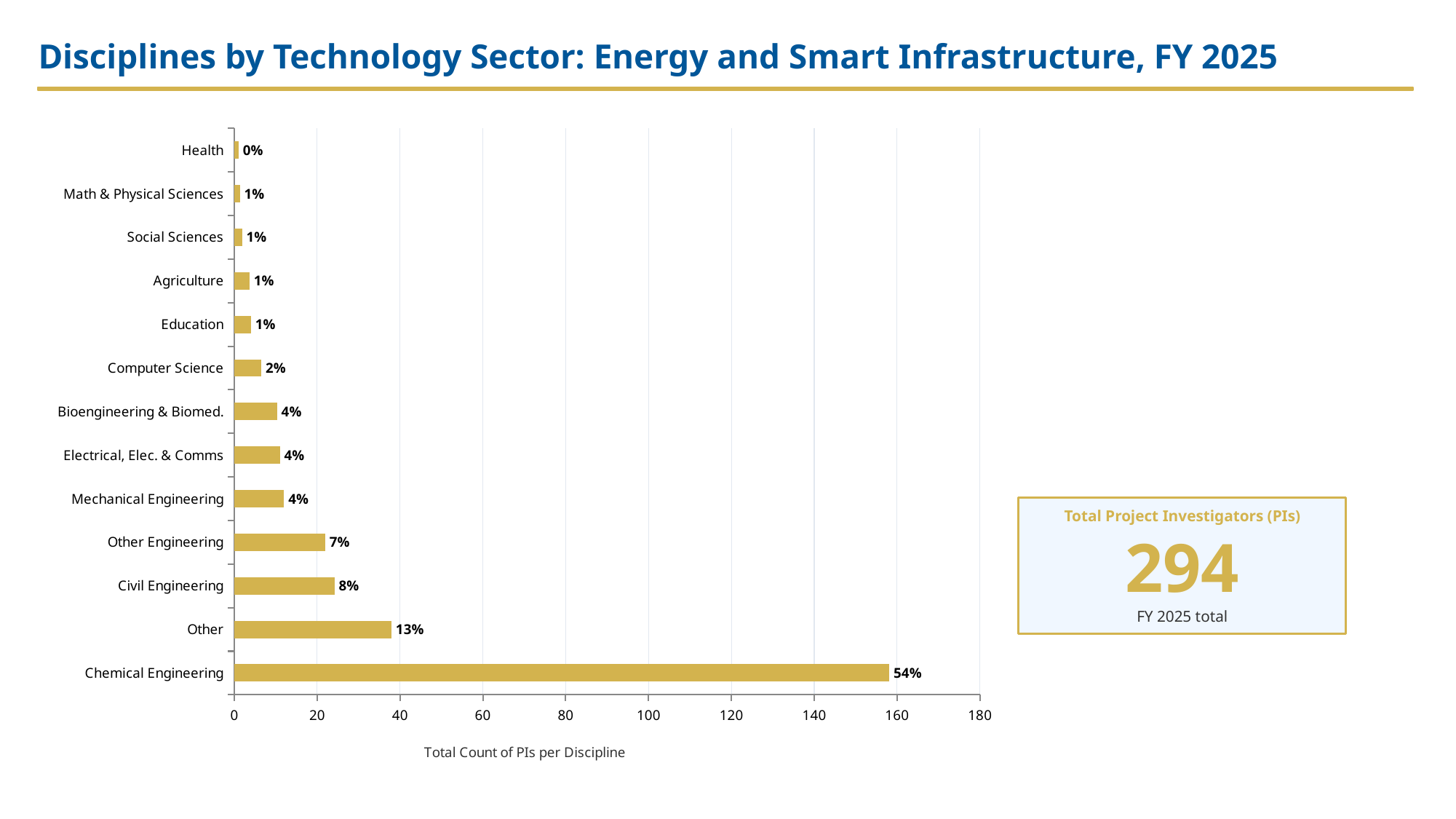
What percentage label is shown for Chemical Engineering? 54% By how many percentage points does Chemical Engineering's share exceed the Other category's share? 41 What percentage label is shown for Civil Engineering? 8% What percentage label is shown for the Other category? 13% Is the PI count for Mechanical Engineering greater or less than 20? less Which has a larger share of PIs, Civil Engineering or Other Engineering? Civil Engineering Which discipline has the highest share of PIs? Chemical Engineering How many disciplines are listed on the chart? 13 Is the PI count for Chemical Engineering greater or less than 140? greater What percentage label is shown for Computer Science? 2% What type of chart is shown on the slide? bar chart Which discipline has the lowest share of PIs? Health